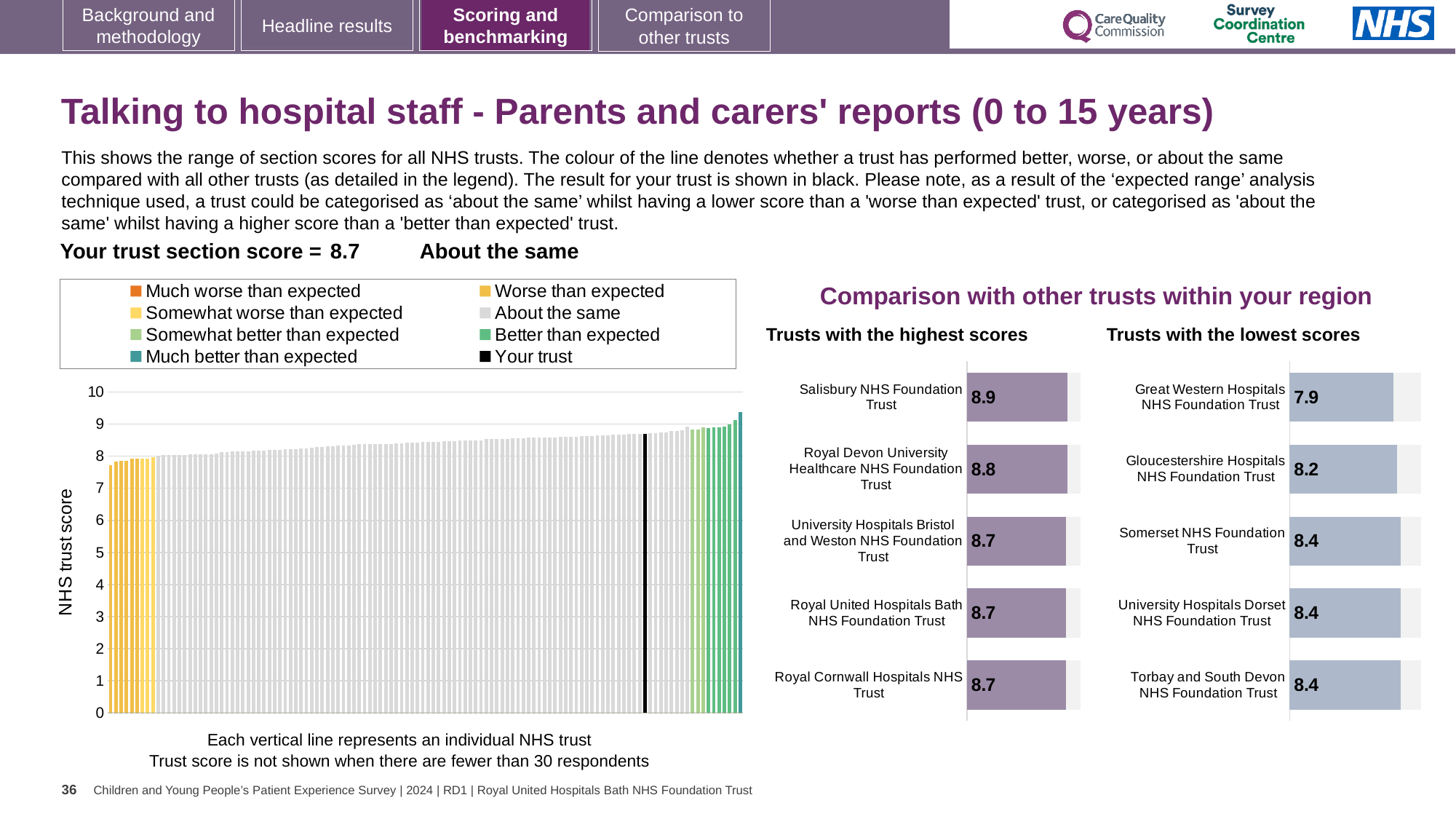
In the 'Trusts with the highest scores' chart, what is the difference between the scores of Salisbury NHS Foundation Trust and Royal Devon University Healthcare NHS Foundation Trust? 0.1 Which is larger: the score for Salisbury NHS Foundation Trust in the highest scores chart or the score for Great Western Hospitals NHS Foundation Trust in the lowest scores chart? Salisbury NHS Foundation Trust In the 'Trusts with the highest scores' chart, what is the score for Royal Devon University Healthcare NHS Foundation Trust? 8.8 How many trusts are shown in the 'Trusts with the highest scores' chart? 5 How many entries does the legend of the large chart on the left list? 8 In the 'Trusts with the highest scores' chart, which trust has the highest score? Salisbury NHS Foundation Trust In the 'Trusts with the lowest scores' chart, which trust has the lowest score? Great Western Hospitals NHS Foundation Trust In the 'Trusts with the highest scores' chart, what is the score for Salisbury NHS Foundation Trust? 8.9 In the 'Trusts with the lowest scores' chart, what is the score for Gloucestershire Hospitals NHS Foundation Trust? 8.2 In the 'Trusts with the lowest scores' chart, what is the score for Great Western Hospitals NHS Foundation Trust? 7.9 In the large chart on the left, is the value of the black 'Your trust' bar greater or less than 8? greater In the 'Trusts with the lowest scores' chart, what is the difference between the scores of Gloucestershire Hospitals NHS Foundation Trust and Great Western Hospitals NHS Foundation Trust? 0.3